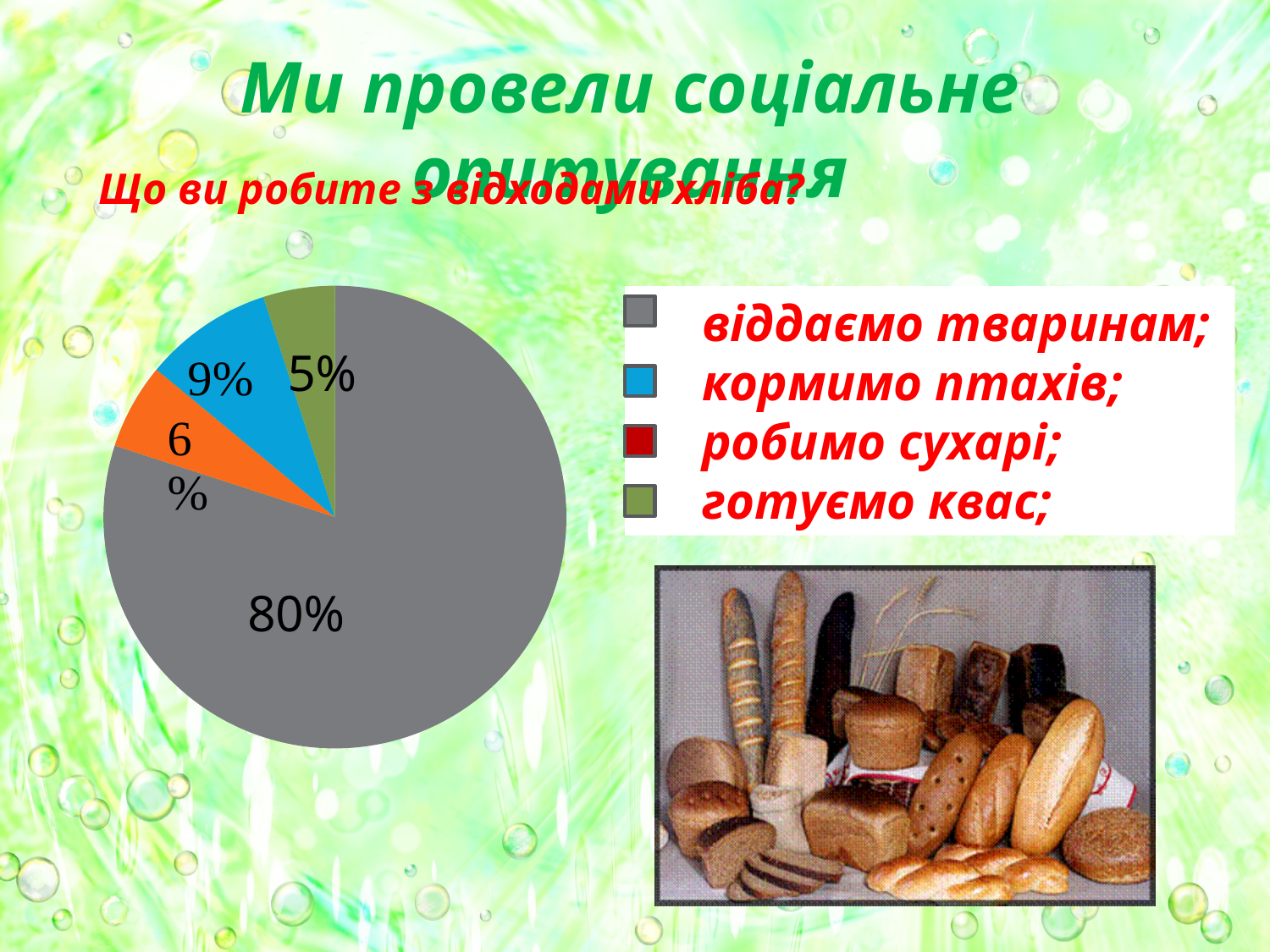
Which answer has the smallest share of the pie? готуємо квас Which answer has the largest share of the pie? віддаємо тваринам What share of respondents answered "готуємо квас"? 5% What is the difference in percentage points between "віддаємо тваринам" and "кормимо птахів"? 71 How many entries does the legend list? 4 What share of respondents answered "робимо сухарі"? 6% What kind of chart is shown on the slide? pie chart How many slices does the pie chart have? 4 What share of respondents answered "віддаємо тваринам"? 80% What share of respondents answered "кормимо птахів"? 9% What colour is the slice for "кормимо птахів"? blue Which is larger, the share for "кормимо птахів" or for "робимо сухарі"? кормимо птахів